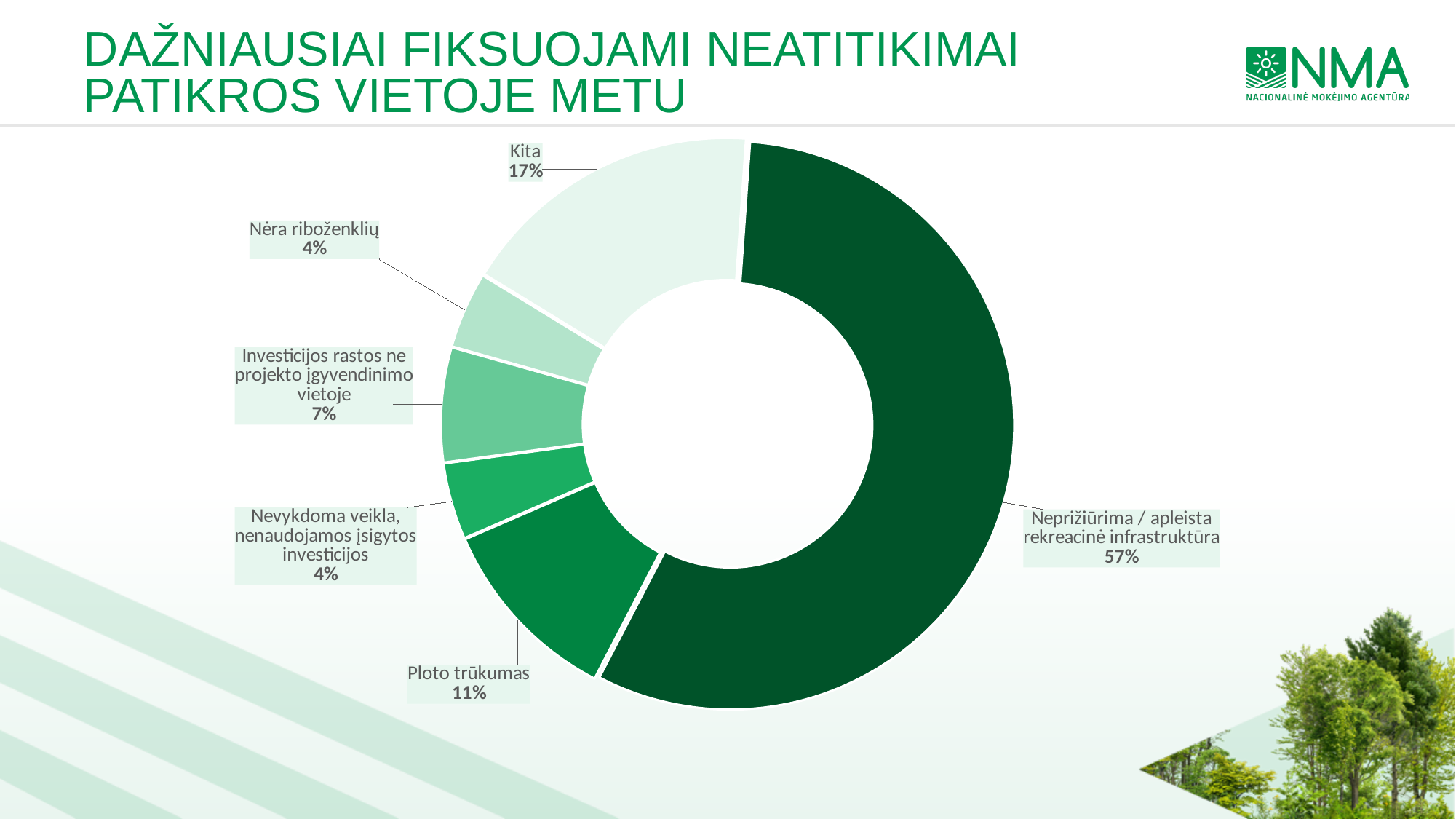
How many categories are shown in the chart? 6 What is the value for "Investicijos rastos ne projekto įgyvendinimo vietoje"? 7% What is the difference in percentage points between "Neprižiūrima / apleista rekreacinė infrastruktūra" and "Kita"? 40 What is the difference in percentage points between "Kita" and "Ploto trūkumas"? 6 What is the value shown for "Ploto trūkumas"? 11% What percentage is shown for "Kita"? 17% Which is larger, the share for "Investicijos rastos ne projekto įgyvendinimo vietoje" or the share for "Nėra riboženklių"? Investicijos rastos ne projekto įgyvendinimo vietoje What kind of chart is shown on the slide? Pie chart (donut) What is the title of the slide? DAŽNIAUSIAI FIKSUOJAMI NEATITIKIMAI PATIKROS VIETOJE METU Which category has the largest share of the chart? Neprižiūrima / apleista rekreacinė infrastruktūra What share of the chart does "Neprižiūrima / apleista rekreacinė infrastruktūra" account for? 57% What percentage is shown for "Nėra riboženklių"? 4%